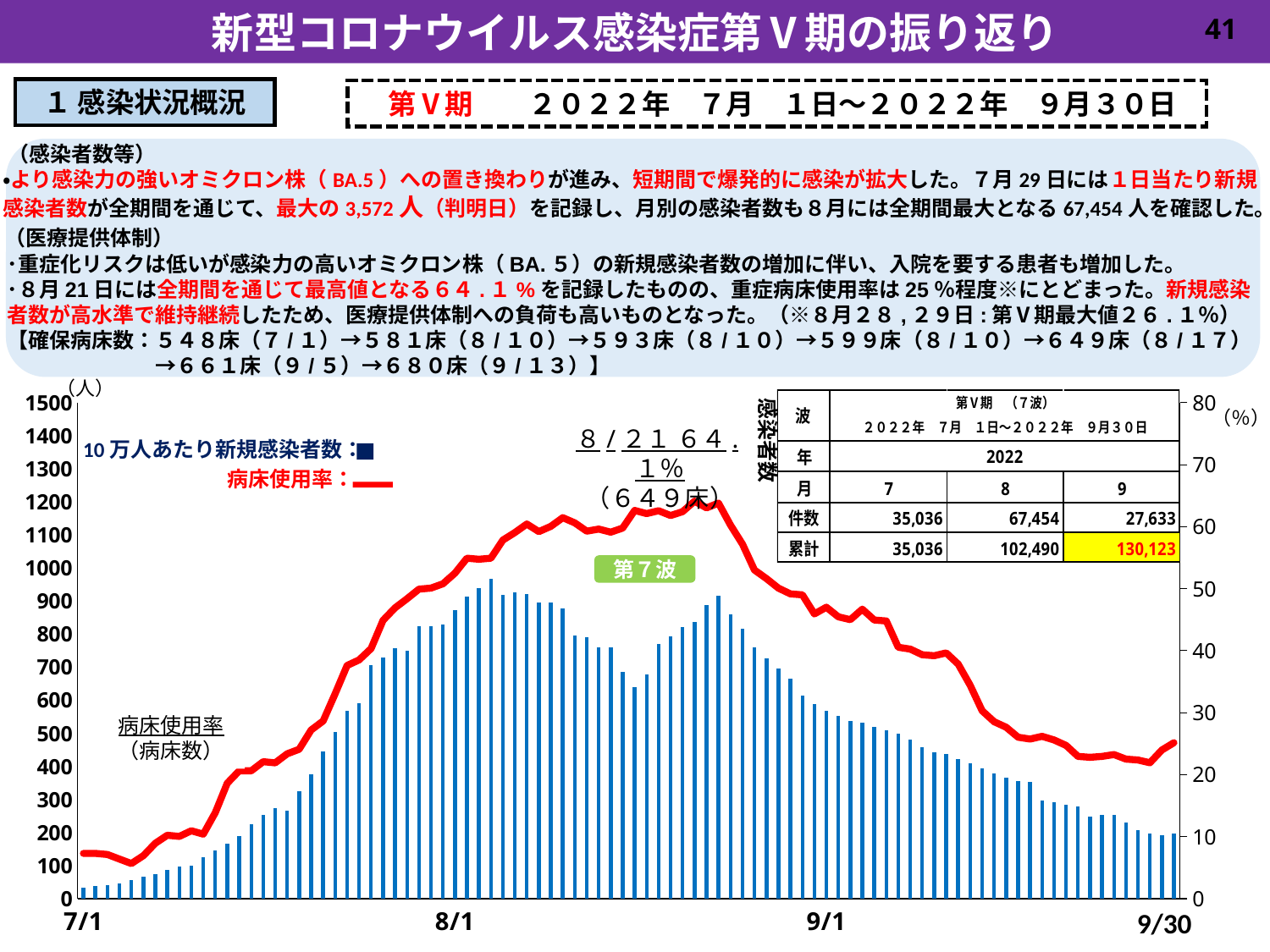
In the table on the chart, what is the 件数 (number of cases) for month 8? 67,454 Is the highest blue bar (10万人あたり新規感染者数) greater or less than 900? greater What wave label is shown in the green box on the chart? 第7波 Is the bed usage rate (red line) on 7/1 greater or less than 20%? less Does the bed usage rate (red line) rise or fall from 8/21 to 9/30? fall In the table on the chart, which month has the highest 件数? 8 How many series does the chart legend list? 2 Is the bed usage rate (red line) on 9/30 greater or less than 30%? less What is the peak bed usage rate (病床使用率) labelled on the chart for 8/21? 64.1% Does the bed usage rate (red line) rise or fall from 7/1 to 8/21? rise What kind of chart is shown on the slide? A combined bar and line chart How many beds (病床数) are shown in the annotation for the 8/21 peak? 649床